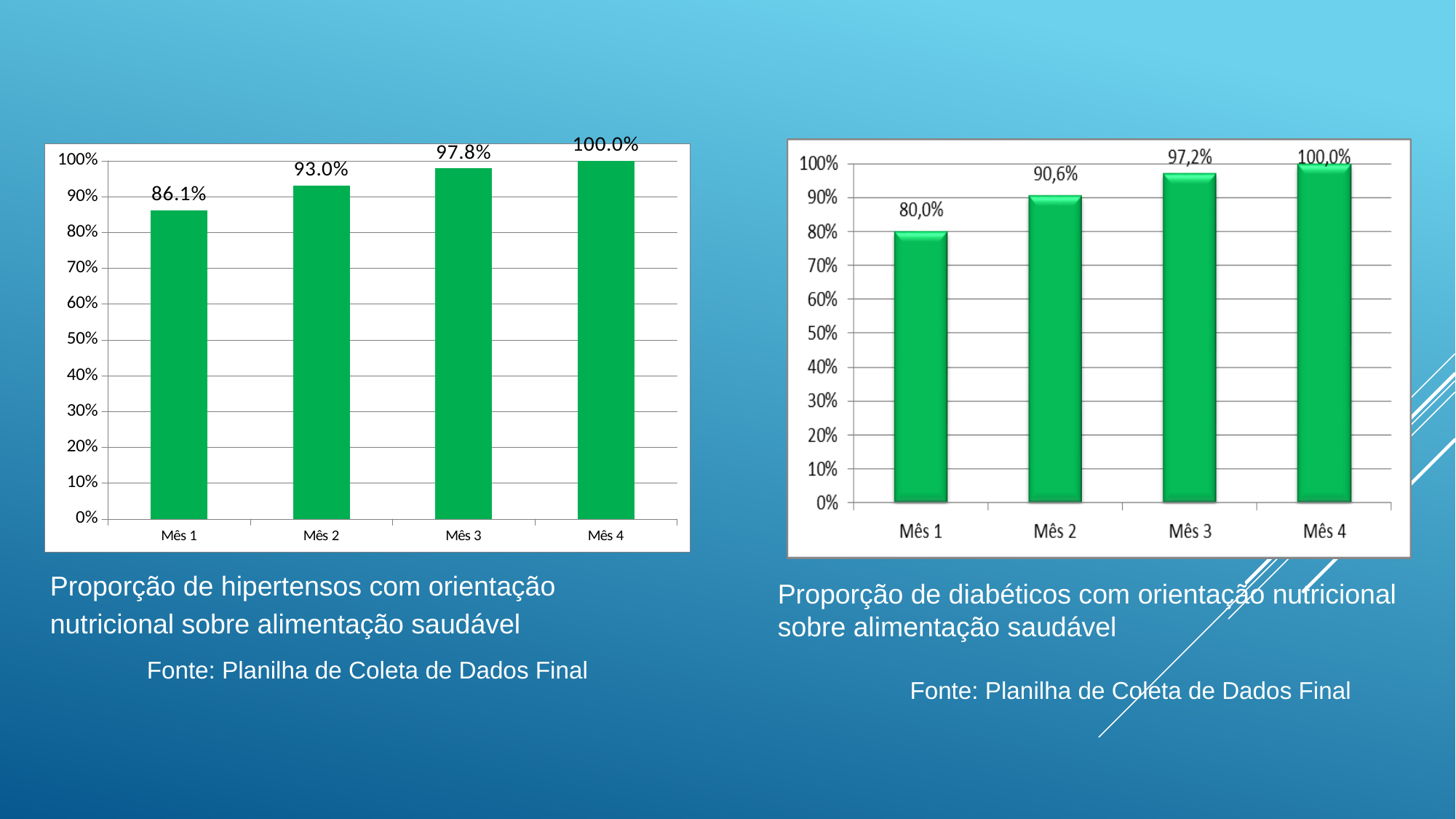
What kind of chart is the right chart (diabéticos)? Bar chart In the right chart (diabéticos), what is the value for Mês 1? 80,0% How many months are shown on the x axis of the left chart (hipertensos)? 4 In the left chart (hipertensos), do the values rise or fall from Mês 1 to Mês 4? Rise In the right chart (diabéticos), which is larger, the value for Mês 2 or the value for Mês 3? Mês 3 In the right chart (diabéticos), what is the difference between the values for Mês 4 and Mês 1? 20,0% In the left chart (hipertensos), which month has the lowest value? Mês 1 In the right chart (diabéticos), which month has the highest value? Mês 4 In the left chart (hipertensos), what is the difference between the values for Mês 2 and Mês 1? 6.9% In the right chart (Proporção de diabéticos com orientação nutricional sobre alimentação saudável), what is the value for Mês 2? 90,6% In the left chart (hipertensos), what is the value for Mês 3? 97.8% In the left chart (Proporção de hipertensos com orientação nutricional sobre alimentação saudável), what is the value for Mês 1? 86.1%